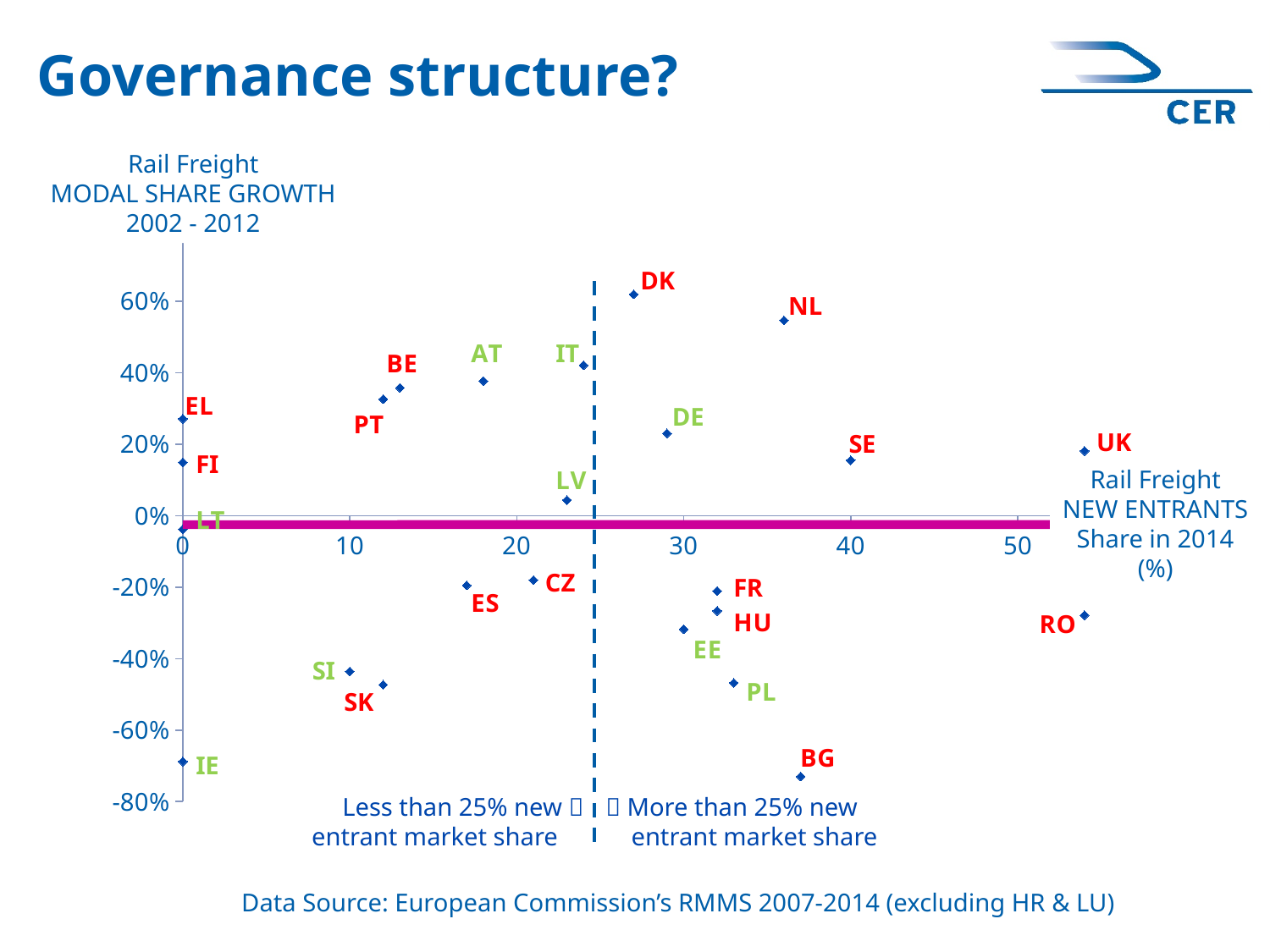
How many countries are plotted on the chart? 24 Which has the higher modal share growth, UK or RO? UK What kind of chart is shown on the slide? scatter chart Which country has the lowest rail freight modal share growth 2002-2012? BG Which has the higher modal share growth, EL or FI? EL Is the modal share growth for AT greater or less than 20%? greater Is the new entrants share in 2014 for UK greater or less than 50? greater Is the modal share growth for BG greater or less than -60%? less Which country has the highest rail freight modal share growth 2002-2012? DK At what new entrant market share is the vertical dashed line drawn? 25%